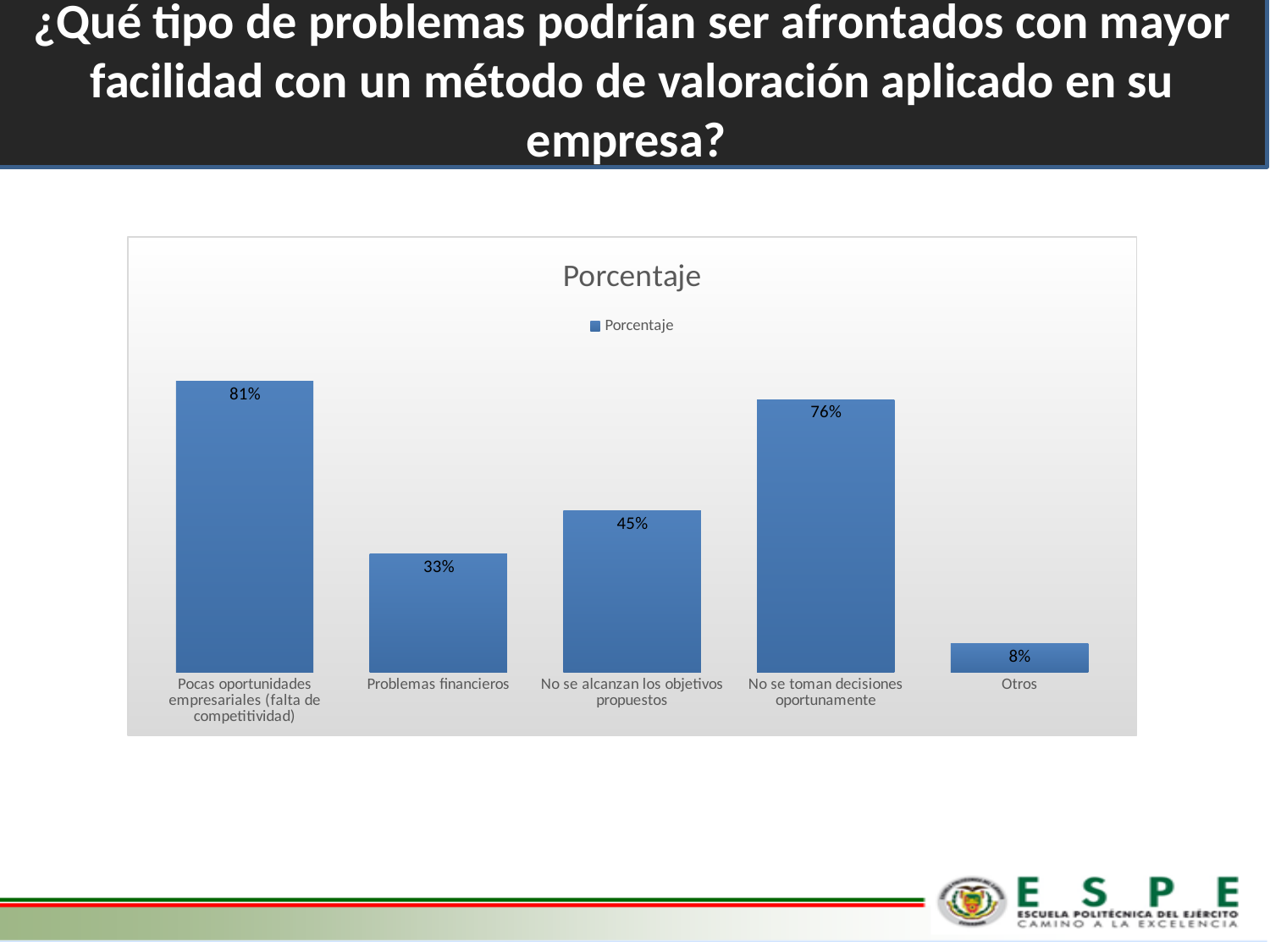
What is the value for "No se alcanzan los objetivos propuestos"? 45% What is the difference between the values for "Pocas oportunidades empresariales (falta de competitividad)" and "No se toman decisiones oportunamente"? 5% Which category has the highest value? Pocas oportunidades empresariales (falta de competitividad) What is the value for "Otros"? 8% What kind of chart is shown on the slide? Bar chart How many categories are shown in the chart? 5 How many series does the legend list? 1 Which is larger, the value for "Problemas financieros" or the value for "No se alcanzan los objetivos propuestos"? No se alcanzan los objetivos propuestos What is the title of the chart? Porcentaje What is the value for "Problemas financieros"? 33% Which category has the lowest value? Otros What is the value for "No se toman decisiones oportunamente"? 76%